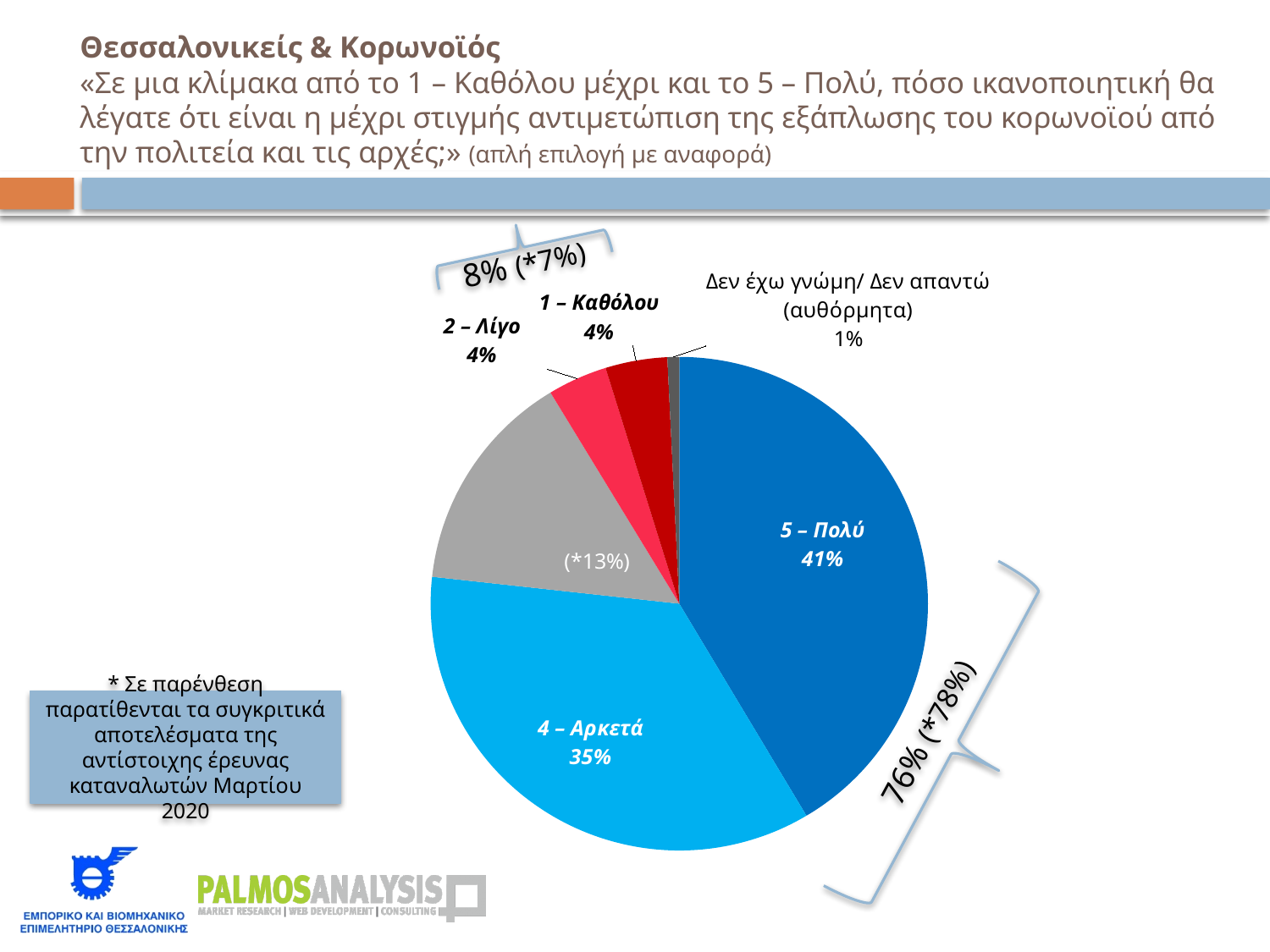
How many slices does the pie chart have? 6 What percentage of respondents answered "1 – Καθόλου"? 4% What is the combined share of "4 – Αρκετά" and "5 – Πολύ" as shown by the bracket on the chart? 76% What percentage of respondents answered "Δεν έχω γνώμη/ Δεν απαντώ"? 1% Which response category has the largest share of the pie? 5 – Πολύ What percentage of respondents answered "5 – Πολύ"? 41% Which is larger, the share for "4 – Αρκετά" or the share for "5 – Πολύ"? 5 – Πολύ What percentage of respondents answered "2 – Λίγο"? 4% What type of chart is shown on the slide? Pie chart How many percentage points larger is the "5 – Πολύ" share than the "4 – Αρκετά" share? 6 What percentage of respondents answered "4 – Αρκετά"? 35% Which response category has the smallest share of the pie? Δεν έχω γνώμη/ Δεν απαντώ